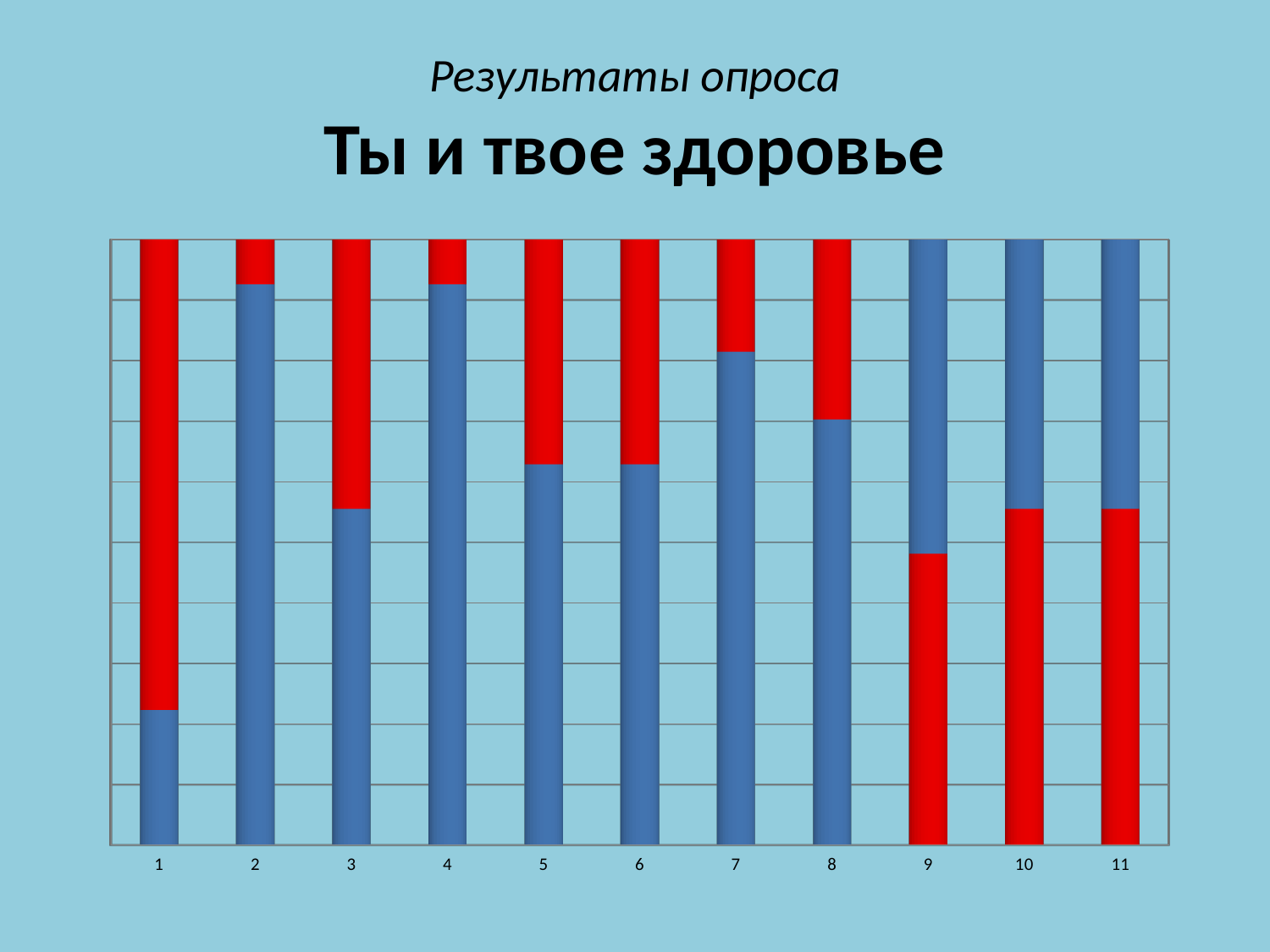
Which category has the larger blue segment, 3 or 5? 5 Which category has the larger red segment, 2 or 3? 3 How many categories are shown along the x axis of the chart? 11 Which category has the larger blue segment, 1 or 7? 7 In which categories does the red segment appear at the bottom of the bar instead of the top? 9, 10 and 11 What two colours are used for the bar segments in the chart? Blue and red Which category has the largest red segment? 1 What kind of chart is shown on the slide? Stacked bar chart What is the title of the chart on the slide? Ты и твое здоровье Which category has the smallest blue segment? 1